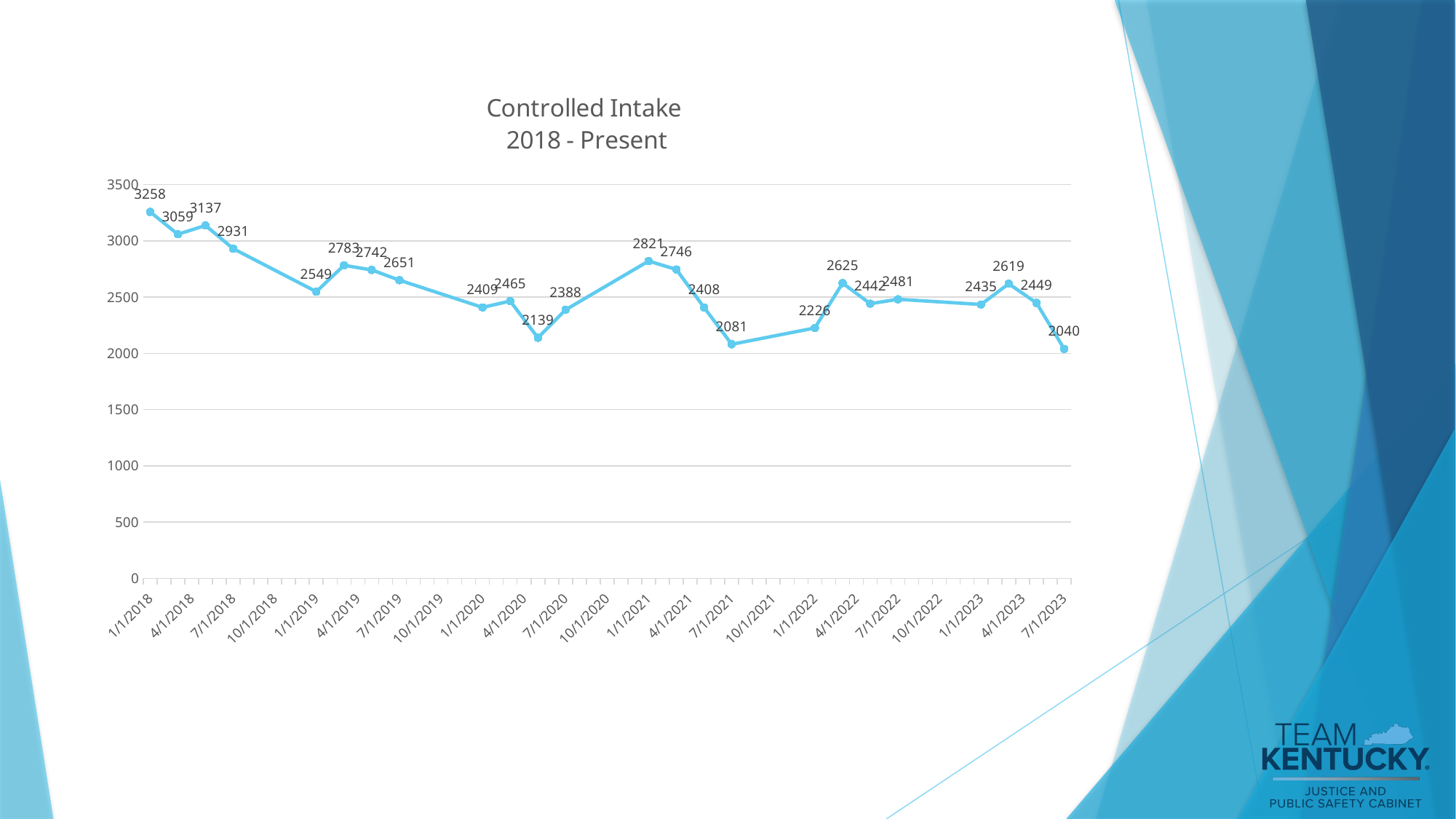
What is the title of the chart? Controlled Intake 2018 - Present What kind of chart is shown on the slide? line chart What is the highest value plotted on the chart? 3258 What is the Controlled Intake value for 1/1/2021? 2821 Which is larger, the value for 1/1/2021 or the value for 1/1/2022? 1/1/2021 What is the Controlled Intake value for 7/1/2021? 2081 What is the Controlled Intake value for 7/1/2023? 2040 What is the difference between the first value (1/1/2018) and the last value (7/1/2023)? 1218 What is the Controlled Intake value for 1/1/2018? 3258 How many data points are plotted on the chart? 24 What is the lowest value plotted on the chart? 2040 Overall, do the values rise or fall from 1/1/2018 to 7/1/2023? fall